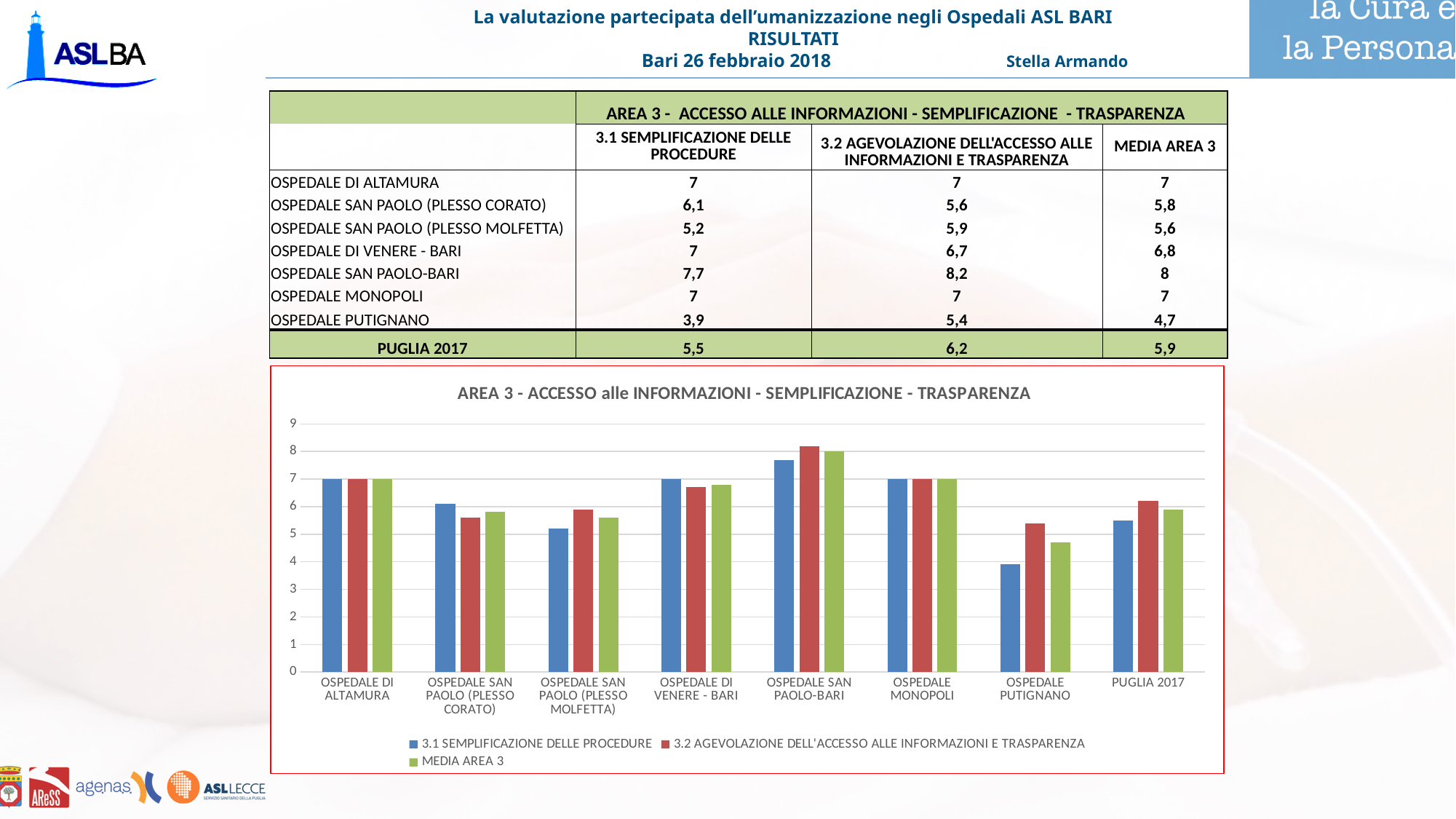
What kind of chart is shown on the slide? bar chart Is the value of 3.2 AGEVOLAZIONE DELL'ACCESSO ALLE INFORMAZIONI E TRASPARENZA for PUGLIA 2017 greater or less than 6? greater Which category has the lowest value for the series 3.1 SEMPLIFICAZIONE DELLE PROCEDURE? OSPEDALE PUTIGNANO What is the difference between the 3.1 SEMPLIFICAZIONE DELLE PROCEDURE values for OSPEDALE SAN PAOLO-BARI and OSPEDALE PUTIGNANO? 3,8 How many series does the chart's legend list? 3 For OSPEDALE SAN PAOLO (PLESSO MOLFETTA), which series has the larger value: 3.1 SEMPLIFICAZIONE DELLE PROCEDURE or 3.2 AGEVOLAZIONE DELL'ACCESSO ALLE INFORMAZIONI E TRASPARENZA? 3.2 AGEVOLAZIONE DELL'ACCESSO ALLE INFORMAZIONI E TRASPARENZA Which category has the highest value for the series 3.2 AGEVOLAZIONE DELL'ACCESSO ALLE INFORMAZIONI E TRASPARENZA? OSPEDALE SAN PAOLO-BARI What is the MEDIA AREA 3 value for OSPEDALE SAN PAOLO-BARI? 8 What is the title of the chart? AREA 3 - ACCESSO alle INFORMAZIONI - SEMPLIFICAZIONE - TRASPARENZA Is the value of 3.1 SEMPLIFICAZIONE DELLE PROCEDURE for OSPEDALE PUTIGNANO greater or less than 4? less What is the value of 3.1 SEMPLIFICAZIONE DELLE PROCEDURE for OSPEDALE DI ALTAMURA? 7 How many categories are shown along the x axis of the chart? 8